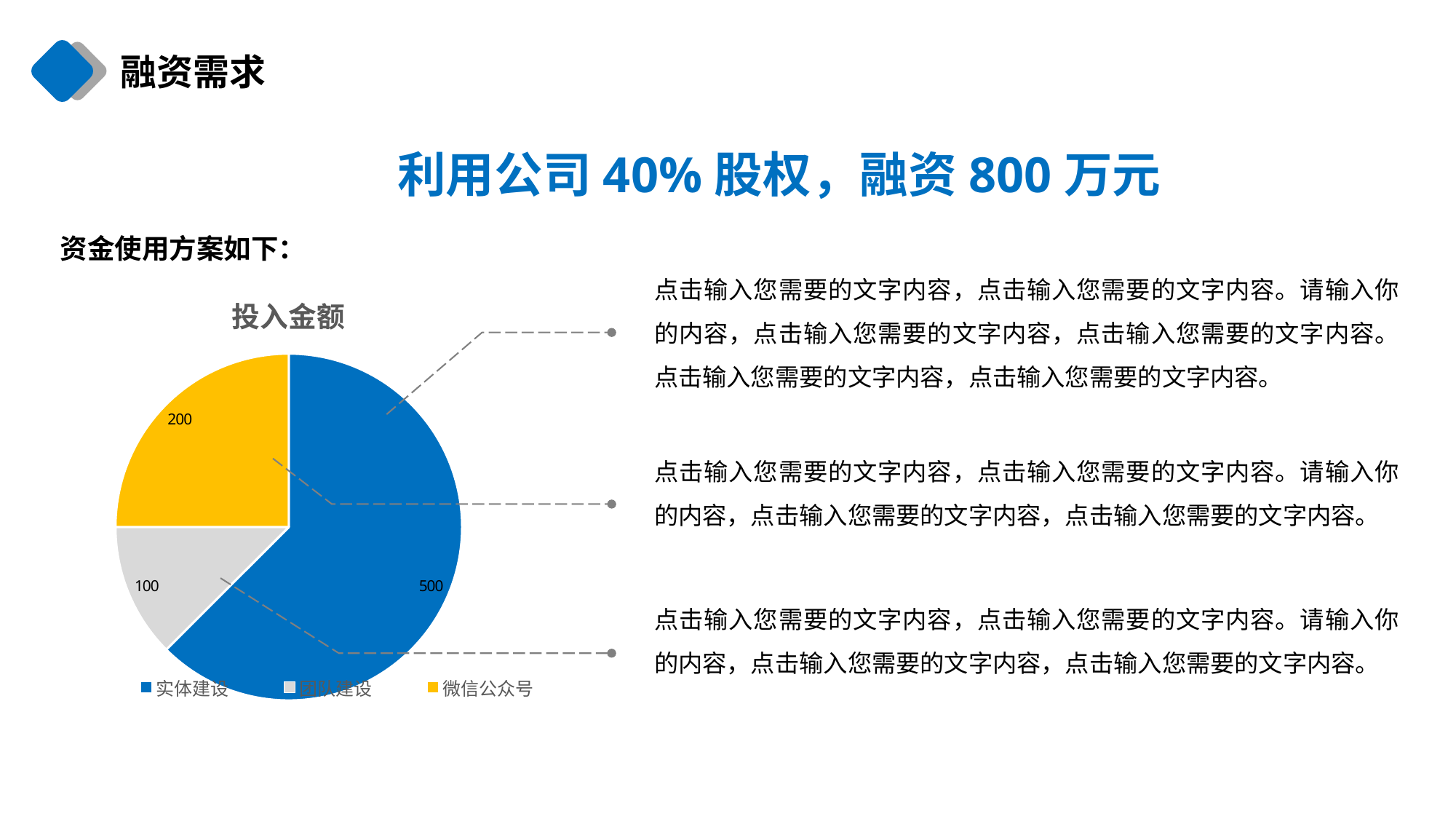
What is the difference between the values for 实体建设 and 微信公众号? 300 What is the title of the chart? 投入金额 What share of the pie does 微信公众号 represent? 25% What is the value for 实体建设 in the pie chart? 500 How many categories does the pie chart have? 3 Which category has the smallest slice in the pie chart? 团队建设 What is the total of all slices in the pie chart? 800 What is the value for 团队建设 in the pie chart? 100 Which is larger, the value for 微信公众号 or the value for 团队建设? 微信公众号 What type of chart is shown on the slide? pie chart Which category has the largest slice in the pie chart? 实体建设 What is the value for 微信公众号 in the pie chart? 200